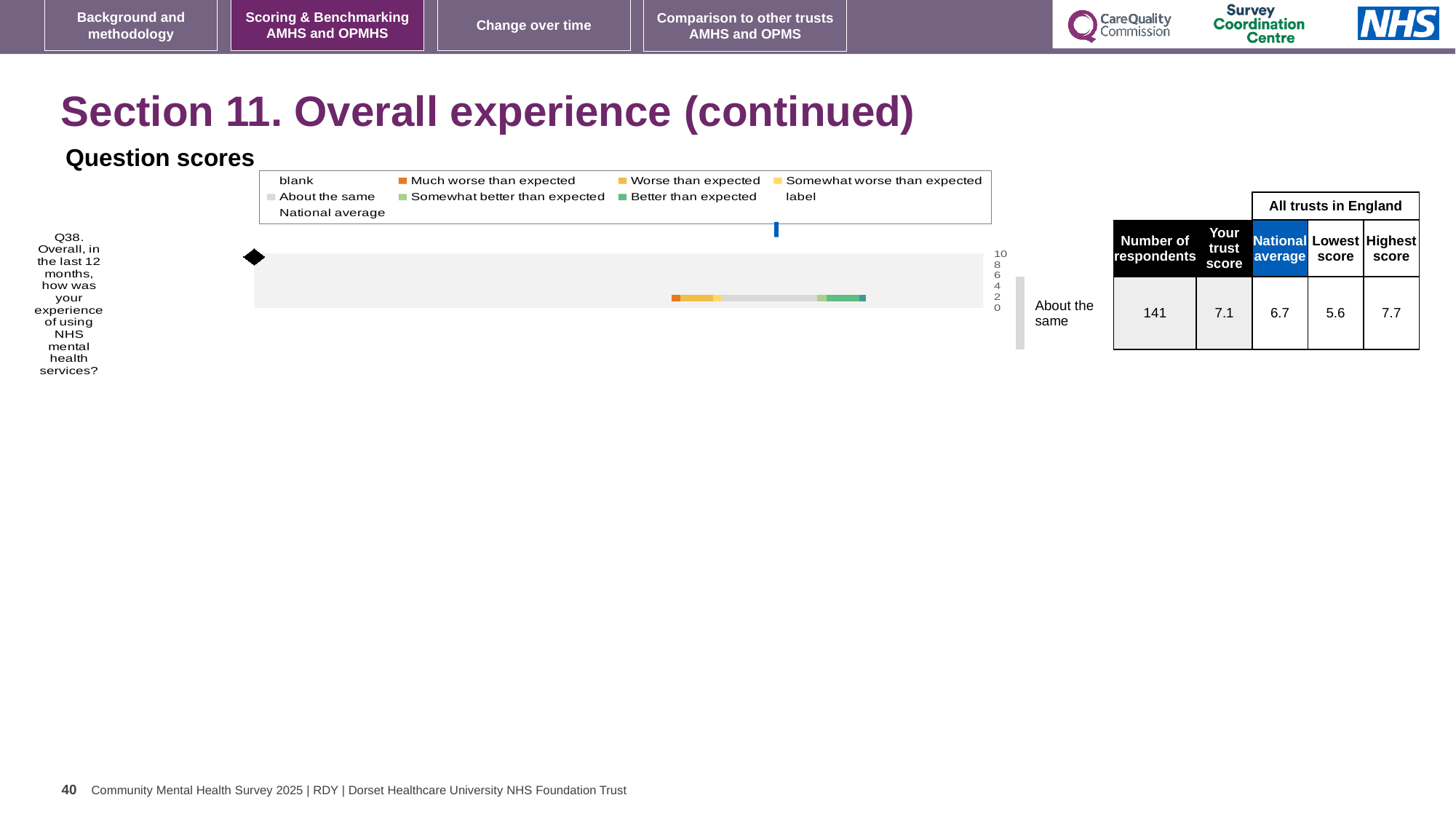
How many questions (categories) are plotted in the Question scores chart? 1 Which question is plotted in the Question scores chart? Q38. Overall, in the last 12 months, how was your experience of using NHS mental health services? In the table beside the chart, what is the difference between the highest score and the lowest score for Q38? 2.1 What is the highest tick value shown on the axis of the Question scores chart? 10 In the table beside the chart, what is the national average for Q38? 6.7 In the table beside the chart, which is larger for Q38: your trust score or the national average? Your trust score In the table beside the chart, what is the number of respondents for Q38? 141 How many entries does the legend of the Question scores chart list? 9 What benchmark category label is shown next to the bar for Q38? About the same What kind of chart is shown under 'Question scores'? bar chart In the table beside the chart, what is 'Your trust score' for Q38? 7.1 In the table beside the chart, is your trust score for Q38 greater or less than 6? greater